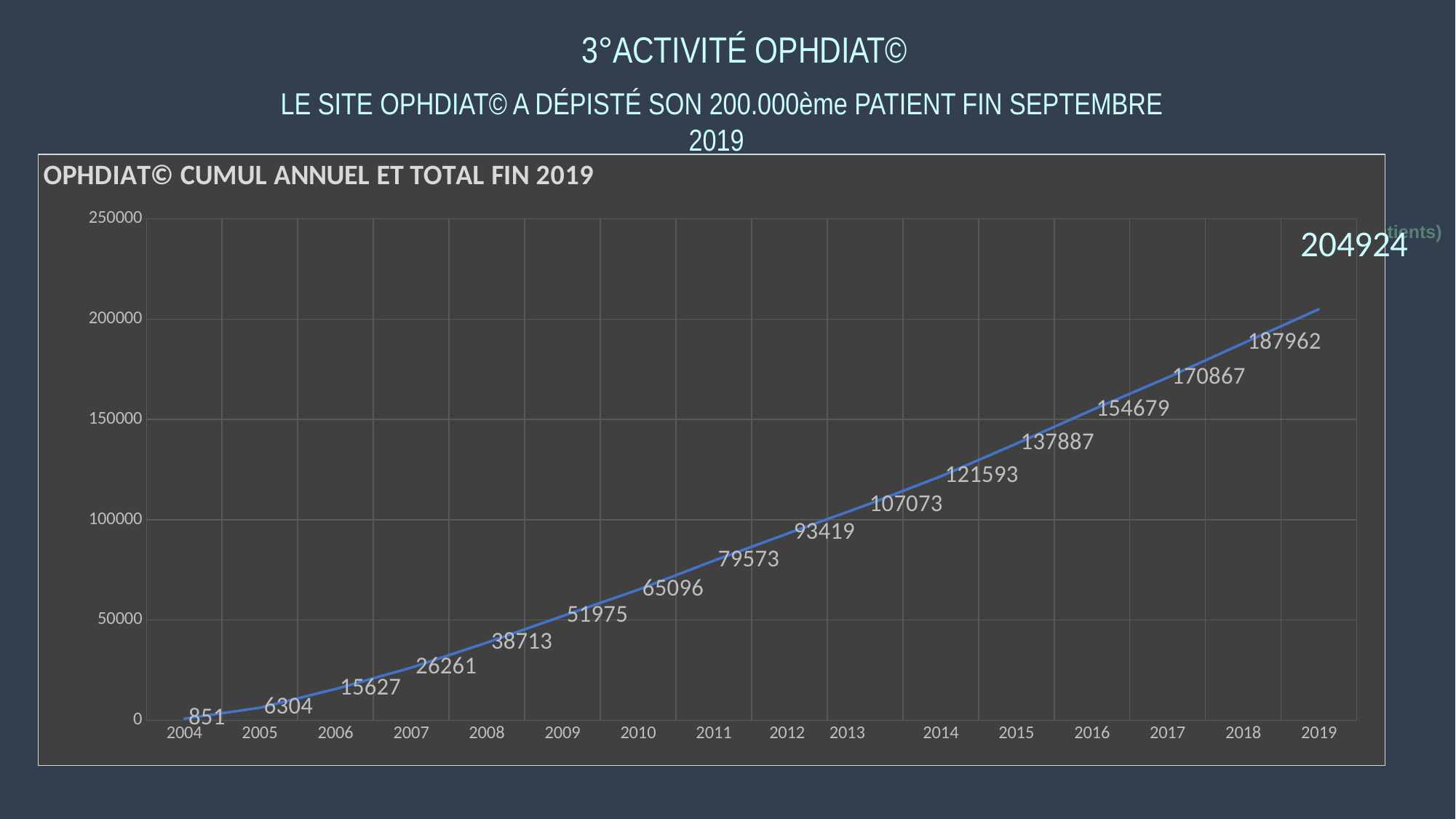
What is the value plotted for 2011? 79573 What is the value shown for 2019? 204924 What is the title of the chart? OPHDIAT© CUMUL ANNUEL ET TOTAL FIN 2019 Which year has the lowest value on the chart? 2004 Is the value for 2013 greater or less than 100000? greater What is the difference between the values for 2018 and 2017? 17095 How many years are plotted on the x axis? 16 Which is larger, the value for 2012 or the value for 2013? 2013 What type of chart is shown on the slide? line chart What is the value plotted for 2016? 154679 What is the value plotted for 2004? 851 Which year has the highest value on the chart? 2019